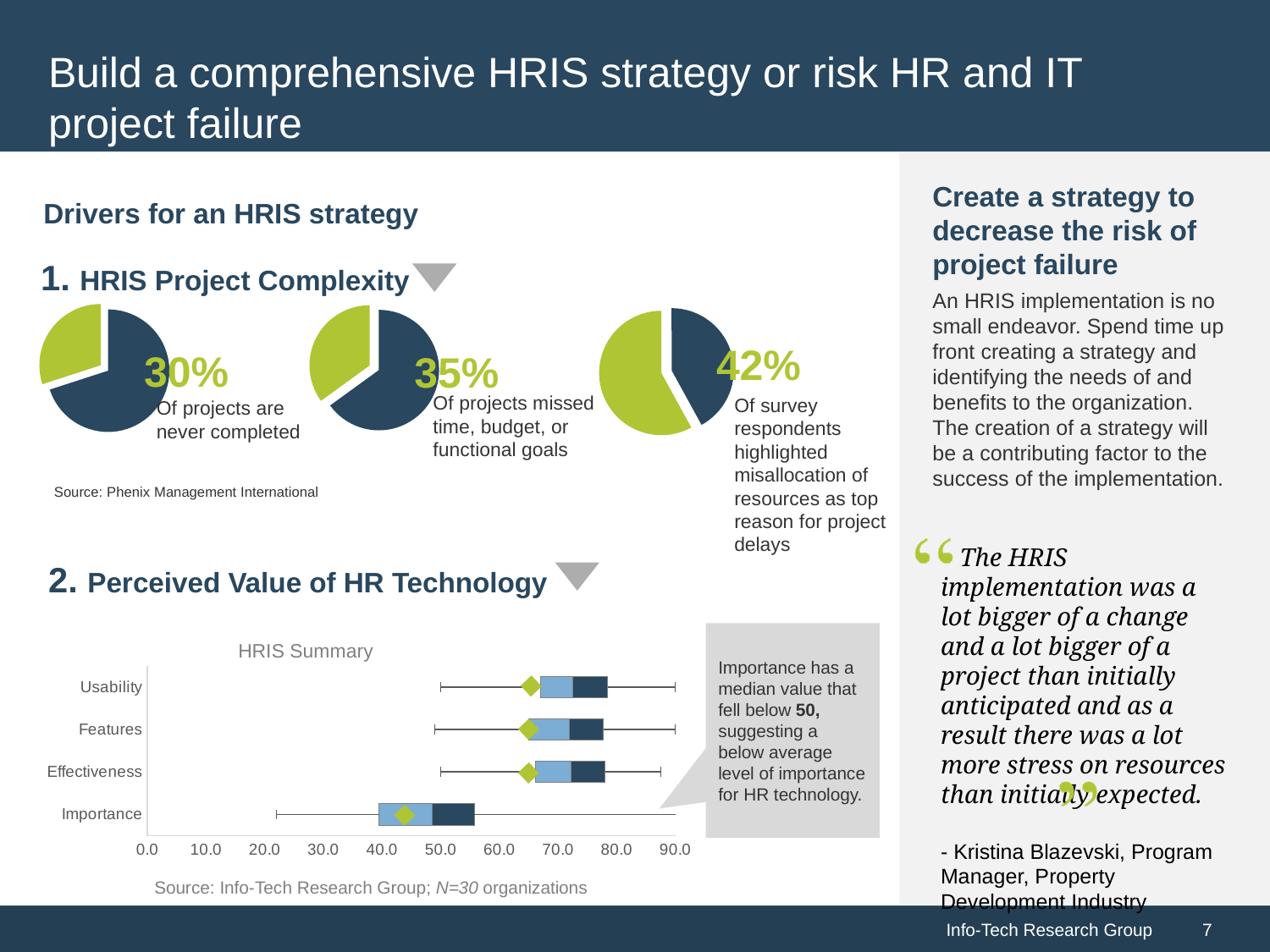
In the HRIS Summary chart, is the median value for Usability greater or less than 60? greater In the HRIS Summary chart, which has the larger median value, Usability or Importance? Usability In the HRIS Summary chart, is the median value for Importance greater or less than 50? less What is the difference between the percentage in the third pie chart (42%) and the first pie chart (30%) under HRIS Project Complexity? 12 percentage points How many pie charts are shown under the HRIS Project Complexity section? 3 What kind of chart is the HRIS Summary chart? Box plot (box-and-whisker chart) In the second pie chart under HRIS Project Complexity, what share of projects missed time, budget, or functional goals? 35% What is the highest value shown on the horizontal axis of the HRIS Summary chart? 90.0 Which of the three pie charts under HRIS Project Complexity shows the largest highlighted percentage? 42% (survey respondents highlighting misallocation of resources) In the HRIS Summary box plot, how many categories are shown on the vertical axis? 4 In the HRIS Summary chart, which category has the lowest median value? Importance In the first pie chart under HRIS Project Complexity, what share of projects are never completed? 30%